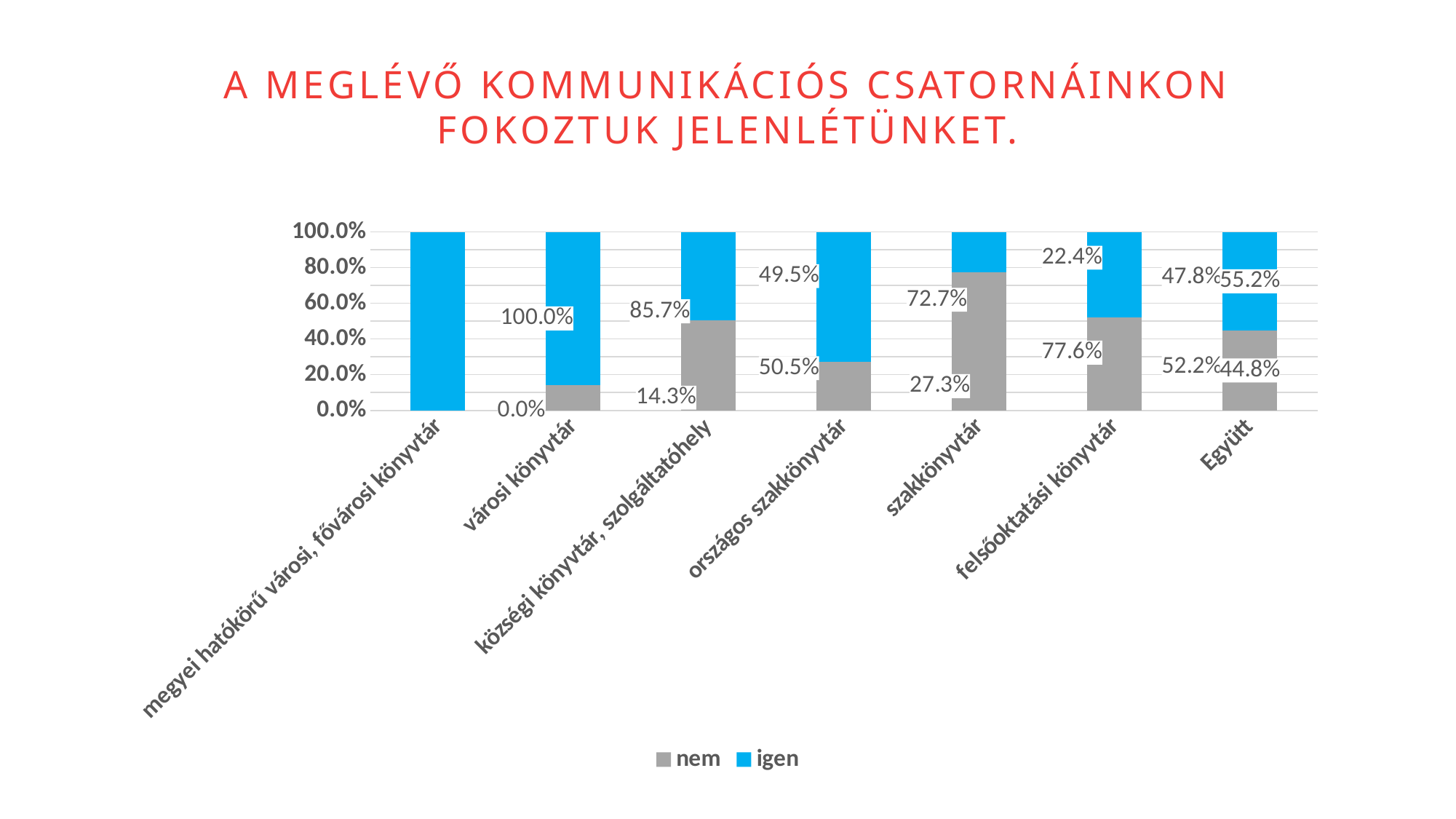
Which colour represents the 'igen' series? blue What kind of chart is shown on the slide? stacked bar chart Which is larger: the 'igen' share for felsőoktatási könyvtár or the 'igen' share for Együtt? Együtt How many library categories are shown on the x axis? 7 Which category has the highest 'nem' share? szakkönyvtár How many series does the legend list? 2 What is the 'igen' share for városi könyvtár? 85.7% What is the 'nem' share for szakkönyvtár? 77.6% Which category has the lowest 'nem' share? megyei hatókörű városi, fővárosi könyvtár What is the difference between the 'igen' share for országos szakkönyvtár and the 'igen' share for szakkönyvtár? 50.3% What is the 'igen' share for Együtt? 55.2% What is the 'nem' share for országos szakkönyvtár? 27.3%